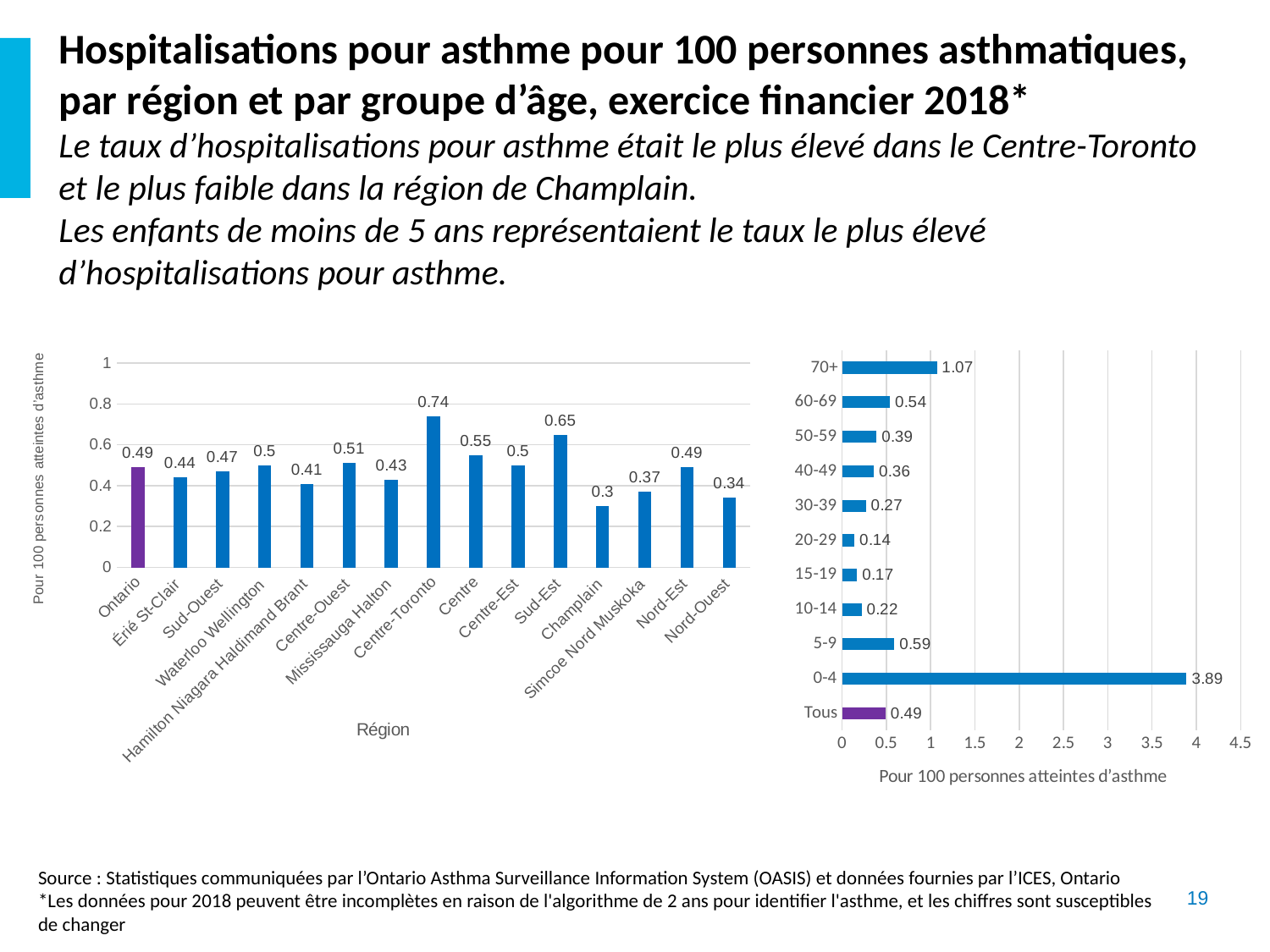
In the left chart (by region), which region has the highest value? Centre-Toronto What kind of chart is the left chart (by region)? Bar chart In the left chart (by region), what is the value for Champlain? 0.3 In the left chart (by region), what is the difference between the values for Centre-Toronto and Champlain? 0.44 In the right chart (by age group), what is the value for the 0-4 age group? 3.89 In the right chart (by age group), how many age-group bars are shown? 11 In the left chart (by region), what is the value for Centre-Toronto? 0.74 In the right chart (by age group), which age group has the lowest value? 20-29 In the right chart (by age group), what is the difference between the values for 70+ and 60-69? 0.53 In the left chart (by region), how many regions are shown on the x axis? 15 In the left chart (by region), which is larger, the value for Sud-Est or the value for Centre? Sud-Est In the left chart (by region), which region has the lowest value? Champlain